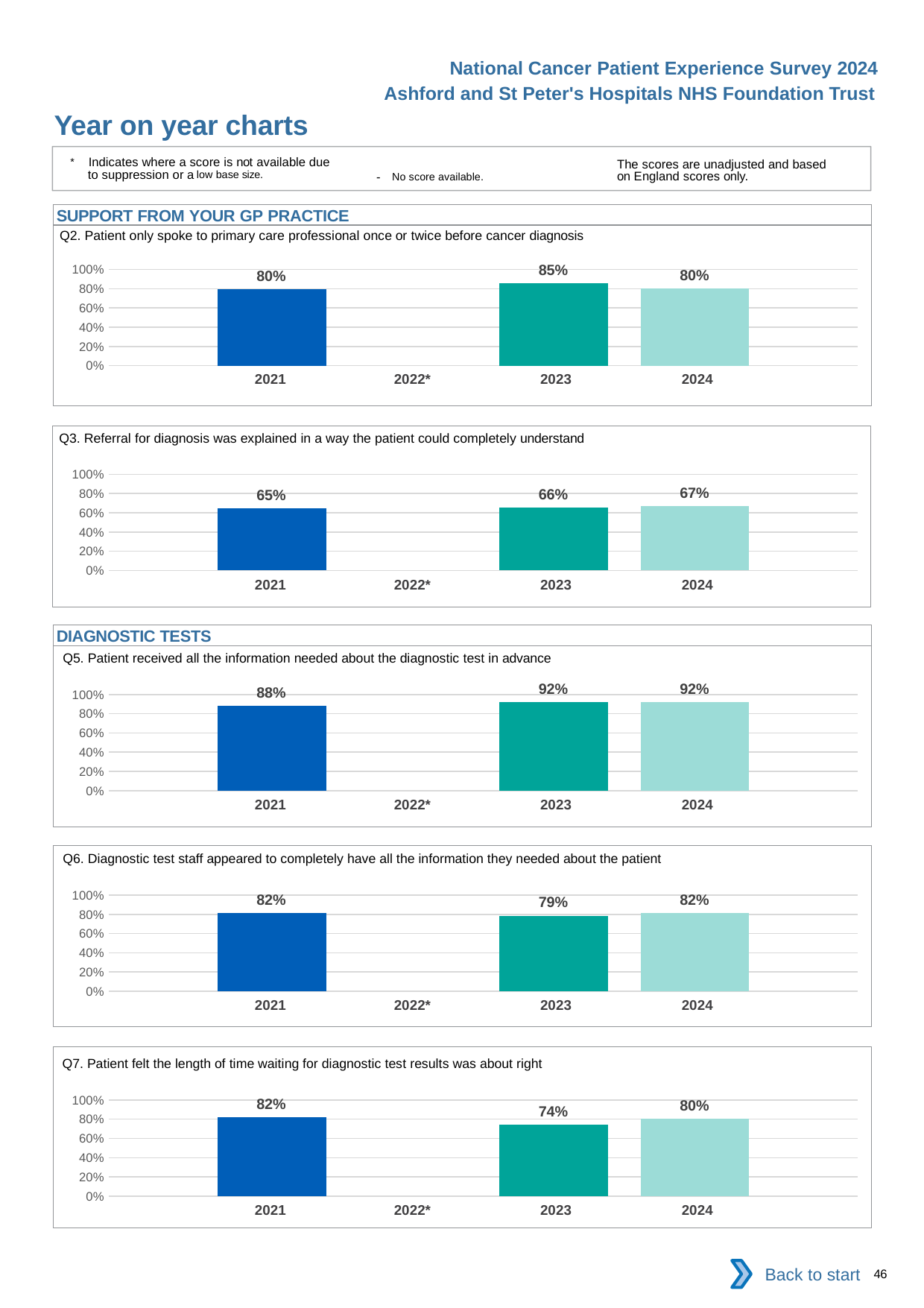
In the Q5 chart, what is the value for 2021? 88% How many years are shown on the x axis of the Q5 chart? 4 In the Q3 chart, is the value for 2021 greater or less than 80%? less In the Q6 chart, which year has the lowest value? 2023 In the Q2 chart, which year has no bar plotted? 2022* In the Q3 chart, do the values rise or fall from 2021 to 2024? rise In the Q2 chart, what is the value for 2023? 85% In the Q7 chart, what is the difference between the 2021 and 2023 values? 8% What kind of chart is the Q6 chart? bar chart In the Q3 chart, what is the value for 2024? 67% In the Q2 chart, which is larger, the value for 2021 or the value for 2023? 2023 In the Q7 chart, which year has the highest value? 2021